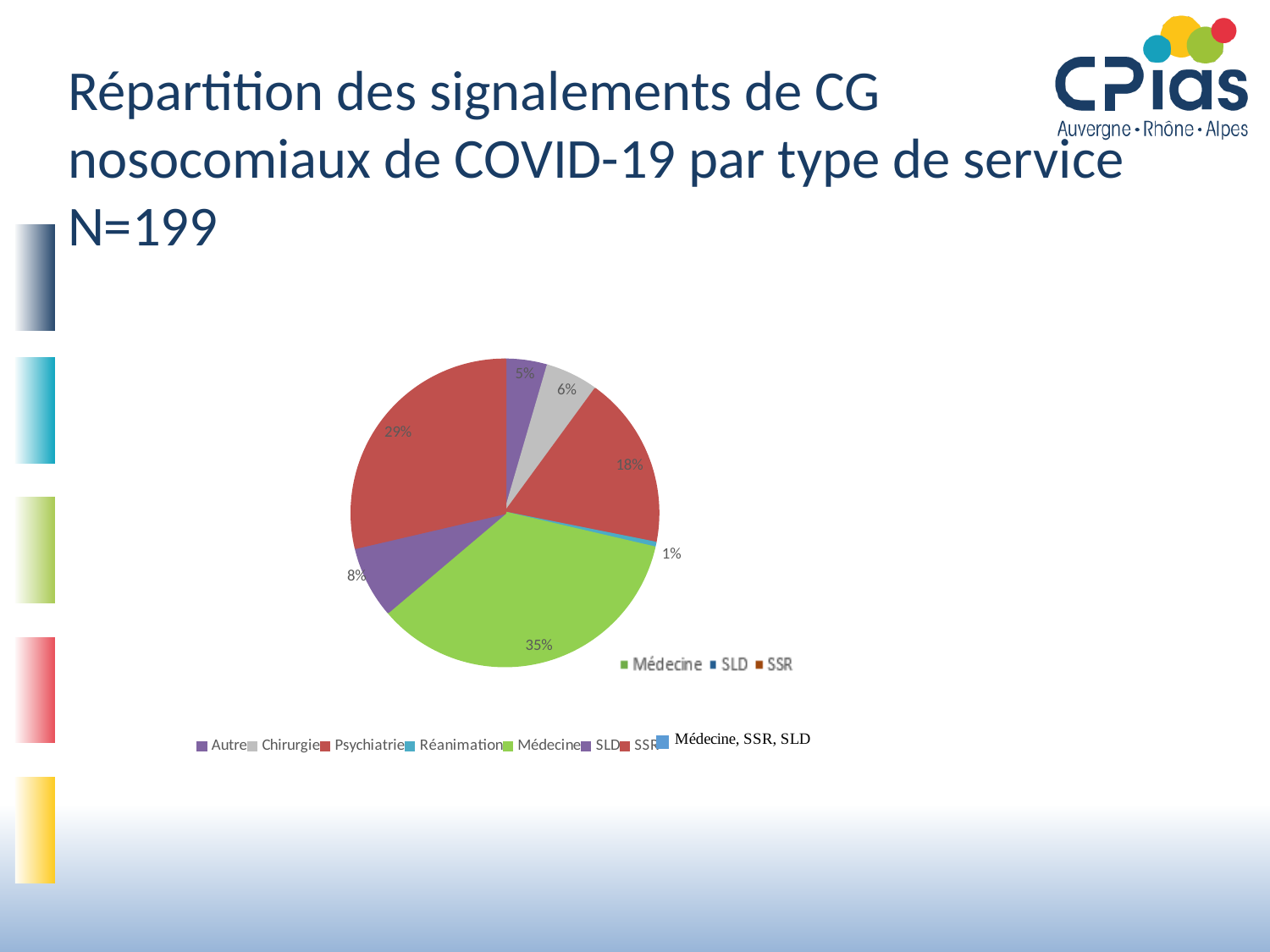
Which is larger, the Psychiatrie slice or the Chirurgie slice? Psychiatrie How many slices does the pie chart have? 7 Which service type has the largest share of the pie chart? Médecine Which service type has the smallest share of the pie chart? Réanimation What percentage is shown for Chirurgie? 6% What kind of chart is shown on the slide? pie chart What is the difference in percentage points between the Médecine slice and the SSR slice? 6 What percentage is shown for SLD? 8% What percentage is shown for Psychiatrie? 18% What is the total number of signalements (N) stated in the slide title? N=199 What share of the pie does SSR represent? 29% What share of the pie does Médecine represent? 35%